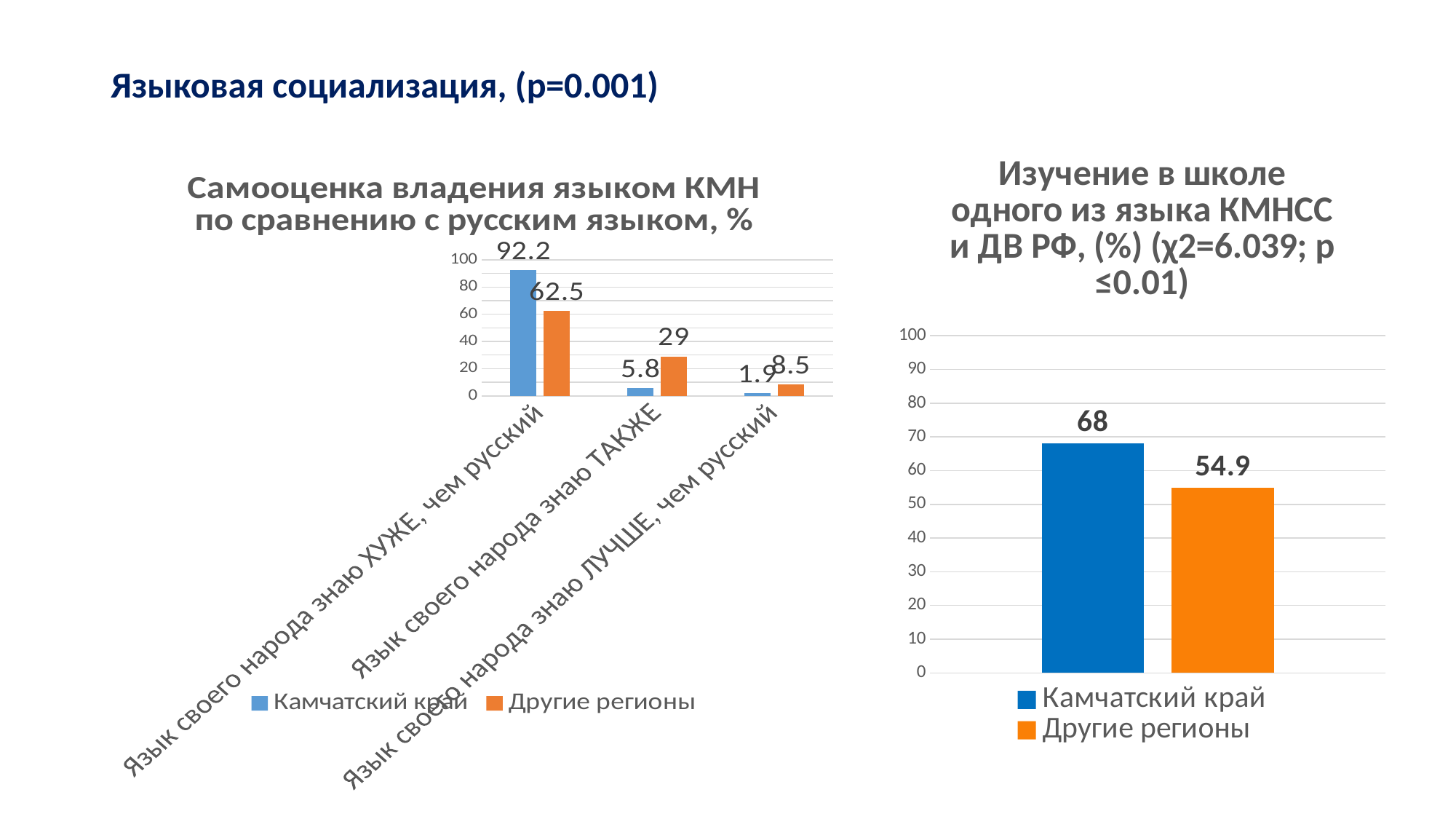
In the left chart, which category has the lowest value for Камчатский край? Язык своего народа знаю ЛУЧШЕ, чем русский How many categories are shown on the x axis of the left chart? 3 In the right chart, what is the value for Другие регионы? 54.9 In the right chart (Изучение в школе одного из языка КМНСС и ДВ РФ), what is the value for Камчатский край? 68 In the left chart, what is the value for Другие регионы in the category 'Язык своего народа знаю ЛУЧШЕ, чем русский'? 8.5 In the left chart (Самооценка владения языком КМН по сравнению с русским языком), what is the value for Камчатский край in the category 'Язык своего народа знаю ХУЖЕ, чем русский'? 92.2 In the left chart, what is the difference between Камчатский край and Другие регионы in the category 'Язык своего народа знаю ХУЖЕ, чем русский'? 29.7 In the left chart, what is the value for Другие регионы in the category 'Язык своего народа знаю ТАКЖЕ'? 29 In the right chart, what is the difference between the values for Камчатский край and Другие регионы? 13.1 What type of chart is the right chart? Bar chart How many series does the legend of the left chart list? 2 In the left chart, which series has the larger value in the category 'Язык своего народа знаю ТАКЖЕ'? Другие регионы